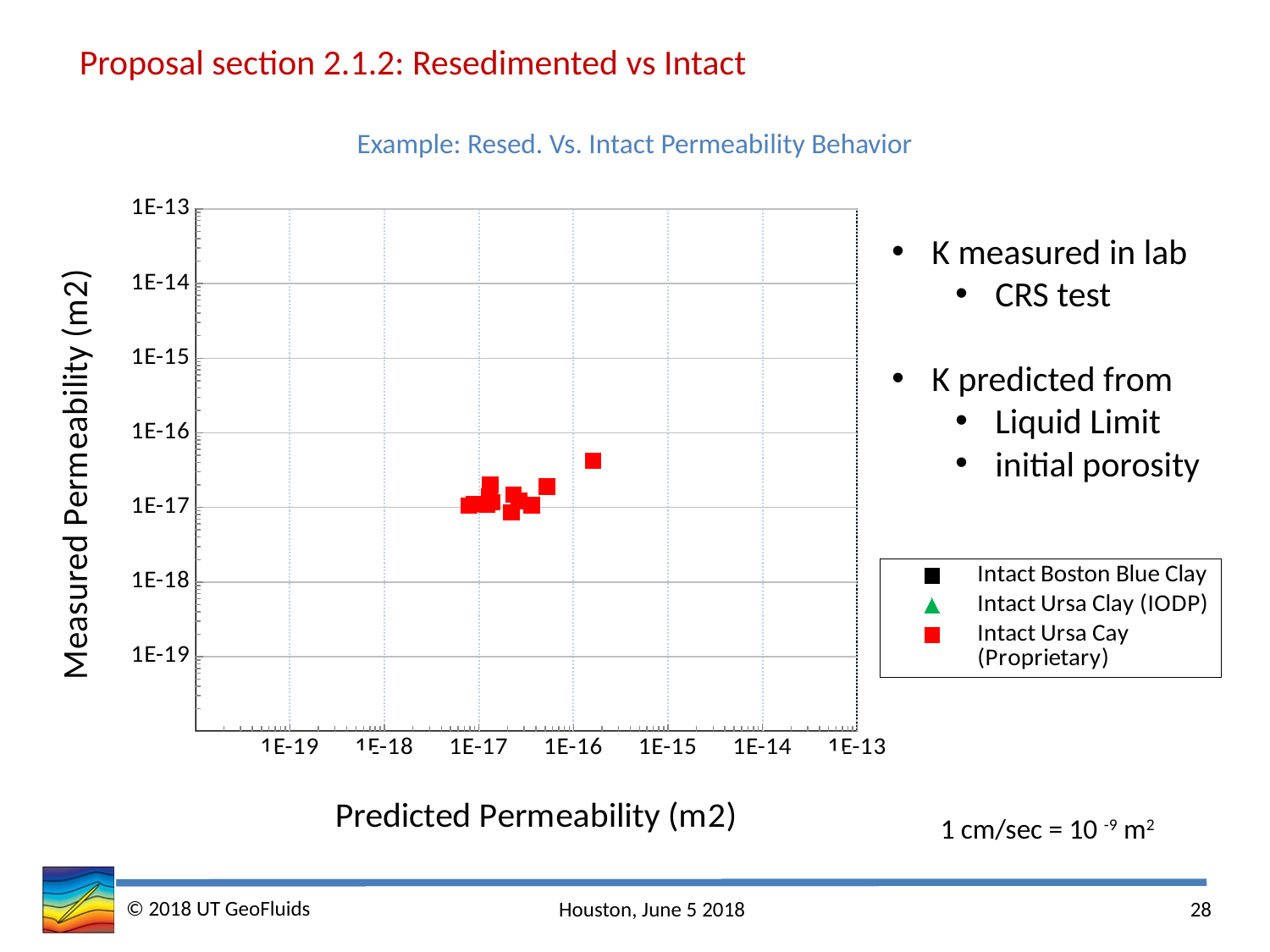
Are the measured permeability values of the plotted points greater or less than 1E-16? less What is the highest value shown on the vertical axis of the chart? 1E-13 How many series does the chart legend list? 3 As predicted permeability increases along the x axis, do the measured permeability values generally rise or fall? rise What is the label of the vertical axis of the chart? Measured Permeability (m2) Is the predicted permeability of the rightmost plotted point greater or less than 1E-16? greater What is the lowest value labelled on the horizontal axis of the chart? 1E-19 Which legend series is plotted with red square markers? Intact Ursa Cay (Proprietary) What is the title of the chart? Example: Resed. Vs. Intact Permeability Behavior Are the measured permeability values of the plotted points greater or less than 1E-18? greater What kind of chart is shown on the slide? scatter chart